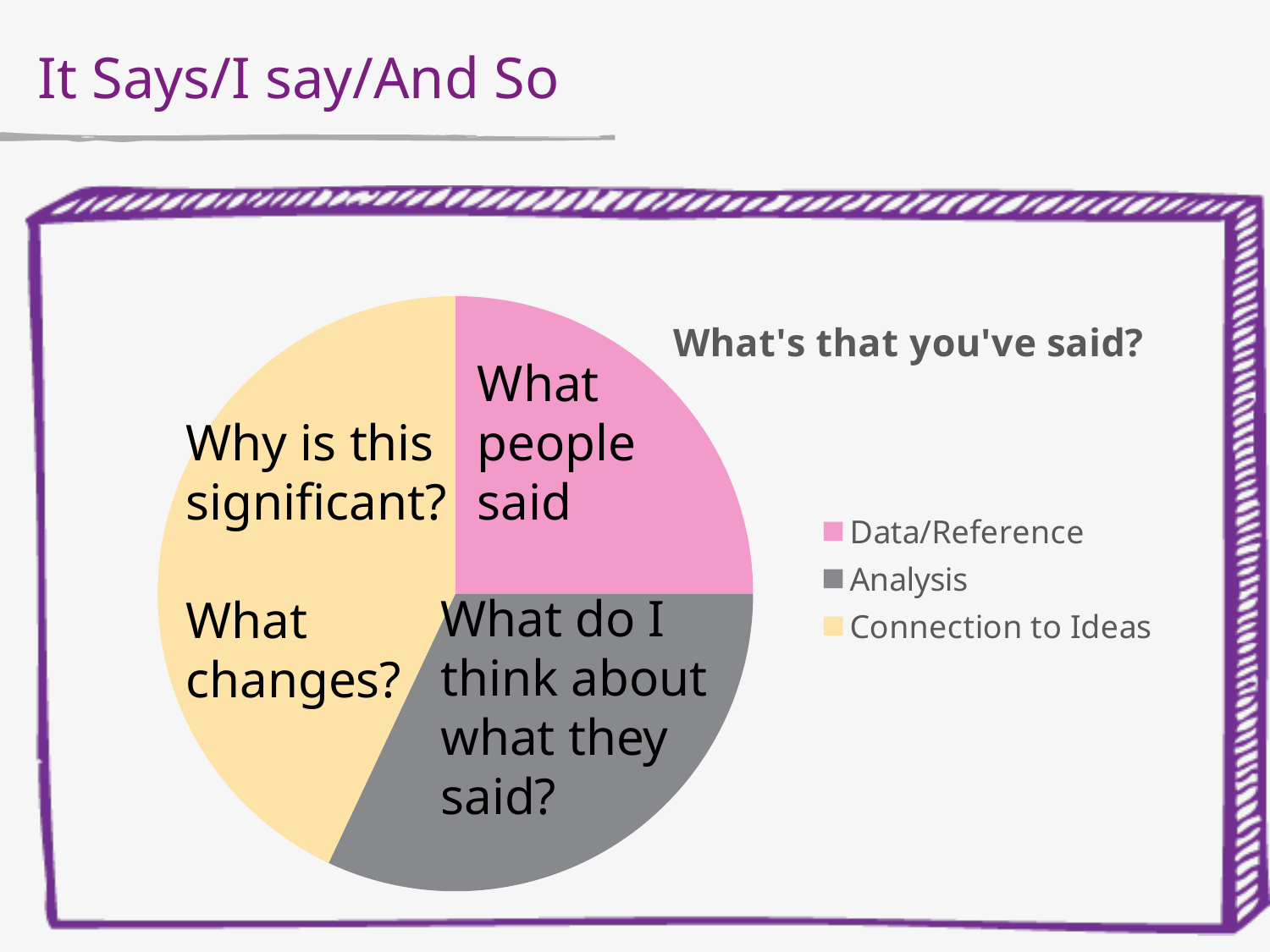
How many entries does the legend of the pie chart list? 3 Which slice is larger, Connection to Ideas or Analysis? Connection to Ideas Which slice is larger, Connection to Ideas or Data/Reference? Connection to Ideas What colour is the Analysis slice of the pie chart? gray What is the title of the pie chart? What's that you've said? How many slices does the pie chart have? 3 Which category has the smallest slice of the pie chart? Data/Reference What kind of chart is shown on the slide? pie chart Which category has the largest slice of the pie chart? Connection to Ideas